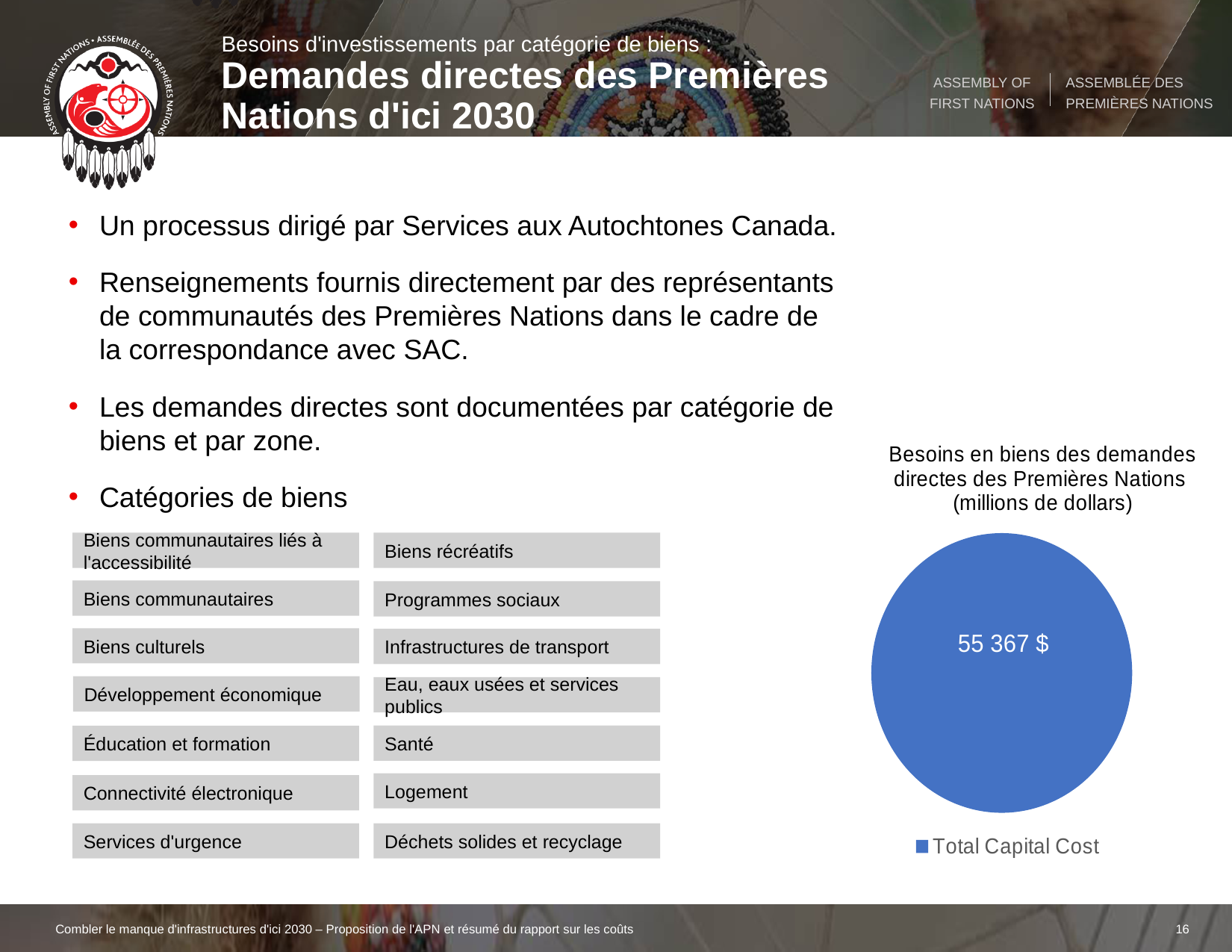
How many slices does the pie chart have? 1 What is the value of Total Capital Cost shown on the pie chart? 55 367 $ How many series does the chart legend list? 1 What is the legend entry of the pie chart? Total Capital Cost What is the title of the pie chart? Besoins en biens des demandes directes des Premières Nations (millions de dollars) What kind of chart is shown on the slide? pie chart What share of the pie does the Total Capital Cost slice represent? 100% What value is shown on the pie chart? 55 367 $